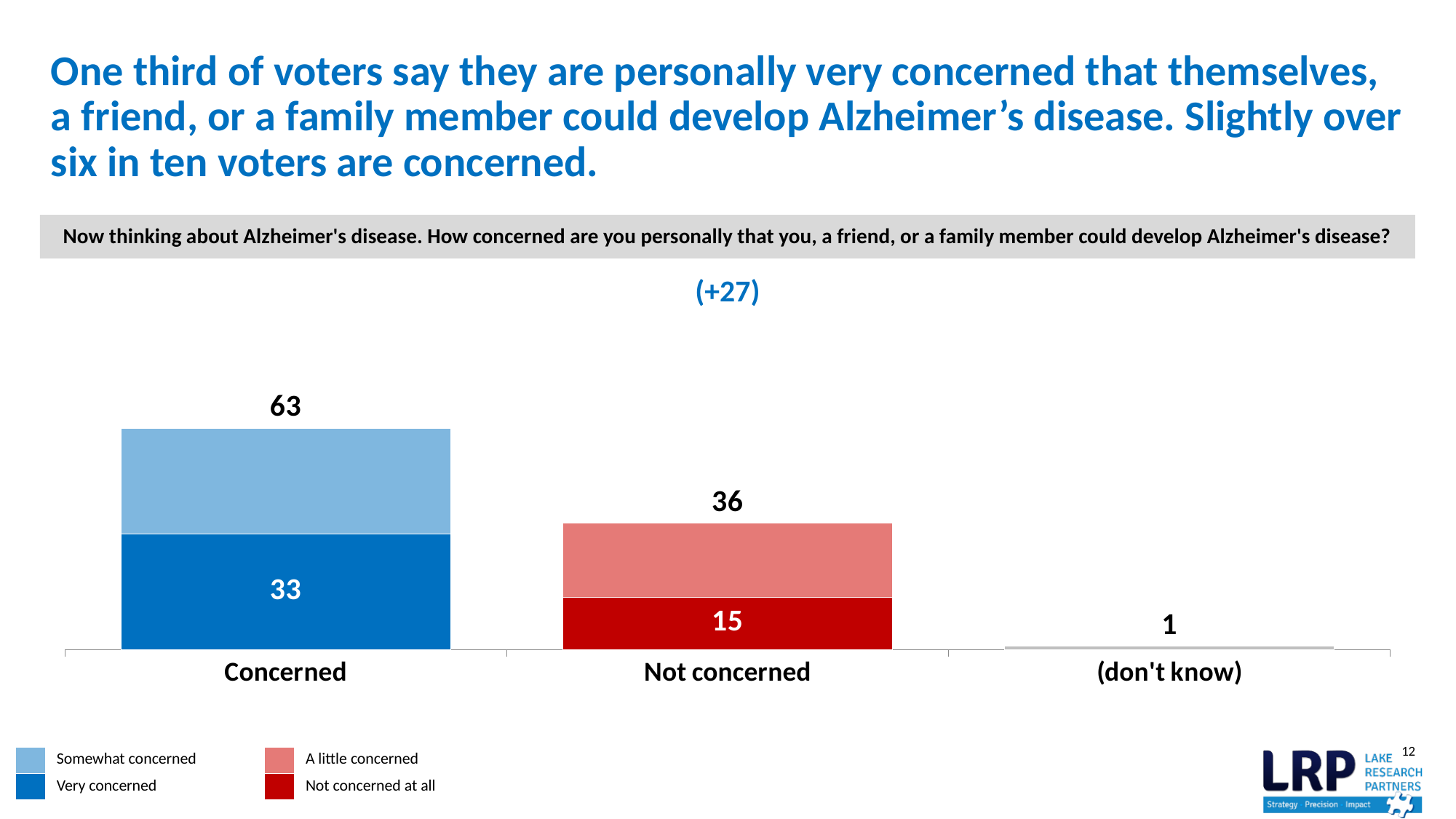
What is the total value of the Concerned bar? 63 What is the difference between the Concerned total (63) and the Very concerned value (33)? 30 What is the difference between the Concerned total and the Not concerned total? 27 Which category has the highest total value? Concerned What is the value for Very concerned within the Concerned bar? 33 What is the total value of the Not concerned bar? 36 How many entries does the legend list? 4 How many categories are shown on the x axis? 3 What is the value for (don't know)? 1 Which category has the lowest value? (don't know) What is the value for Not concerned at all within the Not concerned bar? 15 Which is larger, the Very concerned value or the Not concerned at all value? Very concerned